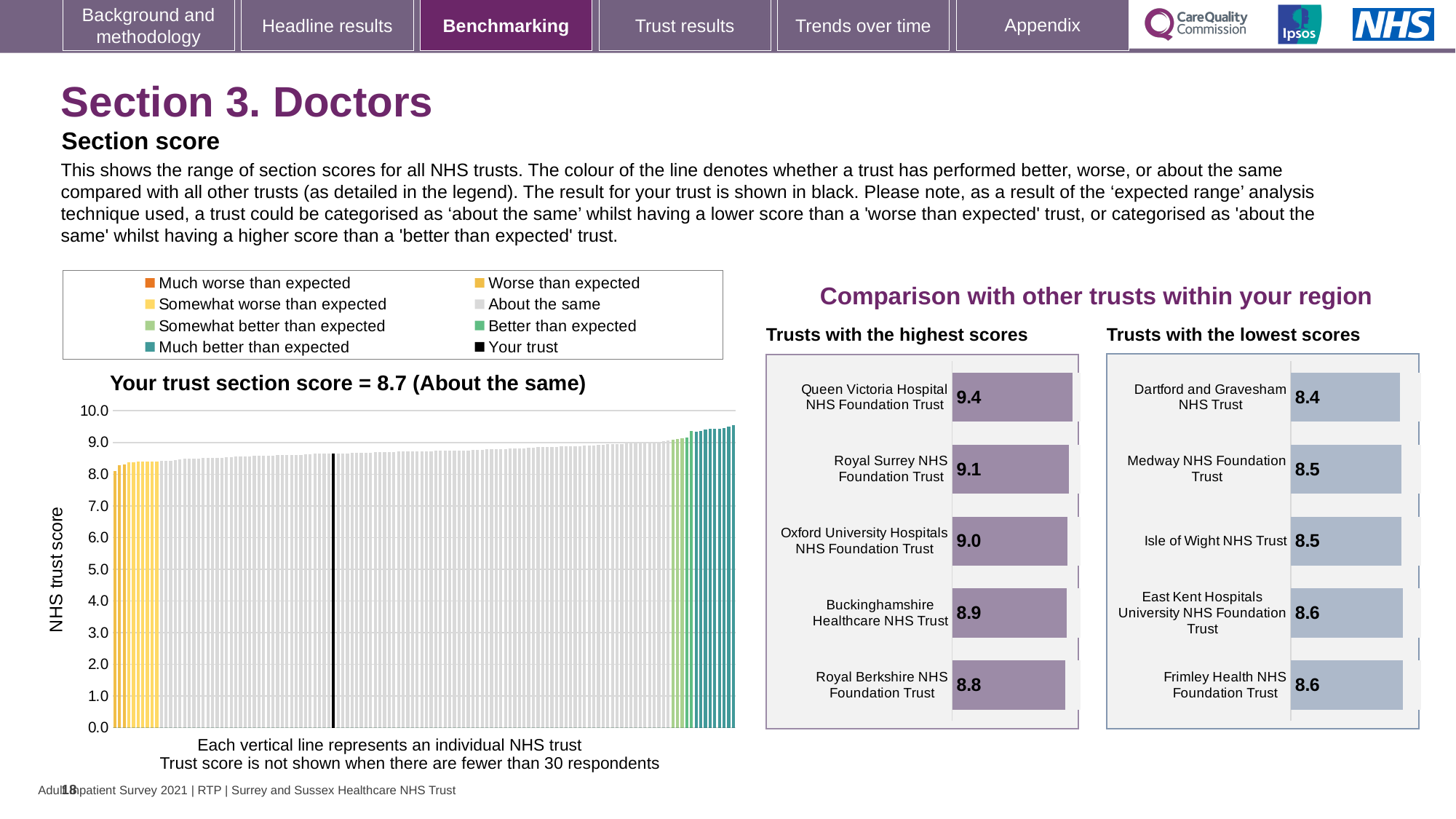
In the 'Your trust section score' chart, what is the section score for your trust? 8.7 In the 'Trusts with the highest scores' chart, how many trusts are shown? 5 In the 'Trusts with the lowest scores' chart, what is the score for Dartford and Gravesham NHS Trust? 8.4 In the 'Your trust section score' chart, is the value of the tallest bar greater or less than 9.0? greater In the 'Trusts with the highest scores' chart, which trust has the lowest score? Royal Berkshire NHS Foundation Trust In the 'Trusts with the highest scores' chart, what is the score for Queen Victoria Hospital NHS Foundation Trust? 9.4 In the 'Your trust section score' chart, how many entries does the legend list? 8 In the 'Your trust section score' chart, what kind of chart is shown? bar chart In the 'Trusts with the lowest scores' chart, what is the difference between the scores of Frimley Health NHS Foundation Trust and Dartford and Gravesham NHS Trust? 0.2 In the 'Your trust section score' chart, what is the label on the vertical axis? NHS trust score In the 'Trusts with the lowest scores' chart, which trust has the lowest score? Dartford and Gravesham NHS Trust In the 'Trusts with the highest scores' chart, what is the difference between the scores of Queen Victoria Hospital NHS Foundation Trust and Royal Berkshire NHS Foundation Trust? 0.6